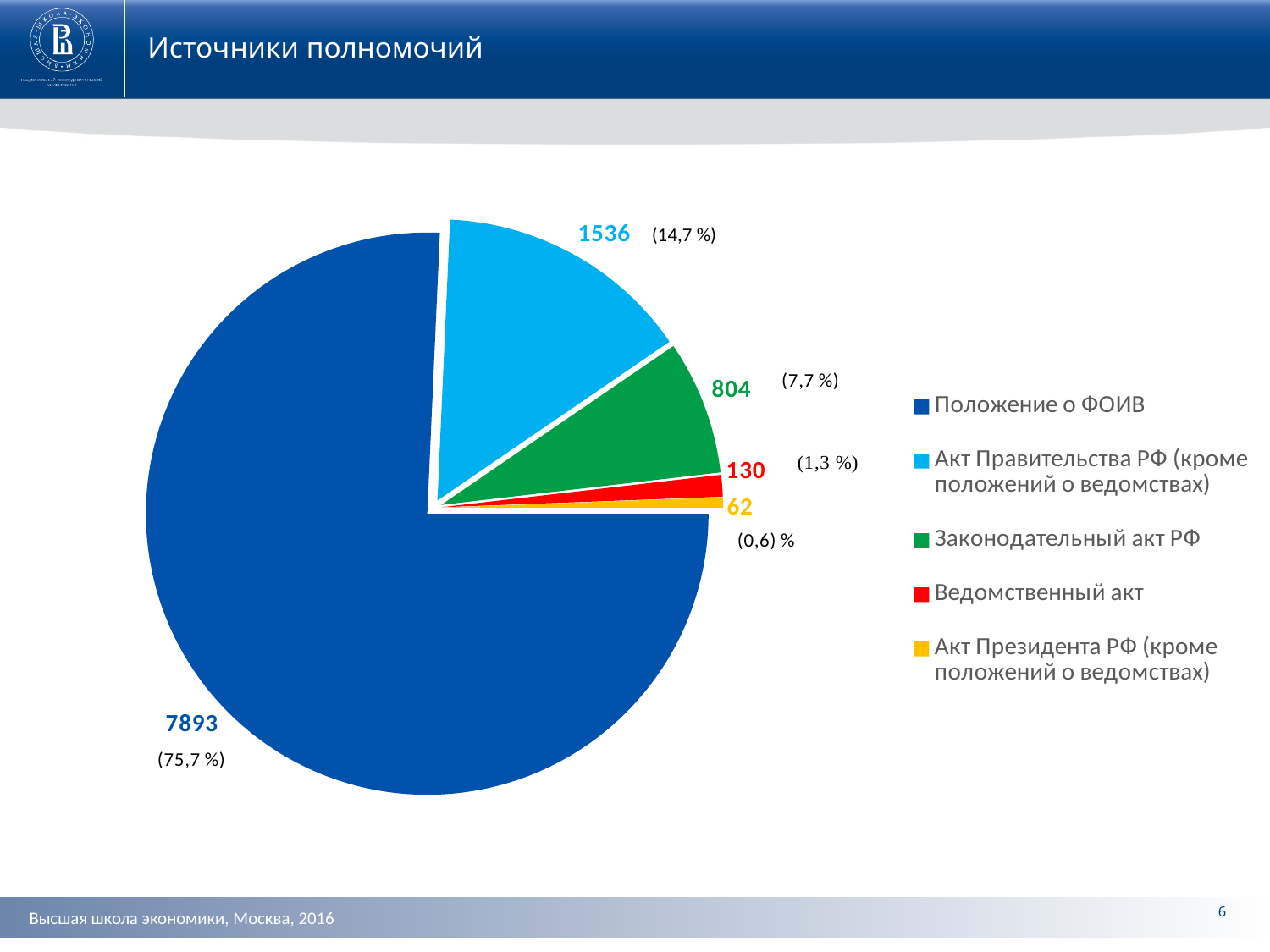
What is the difference between the values for Акт Правительства РФ (кроме положений о ведомствах) and Законодательный акт РФ? 732 How many categories does the pie chart have? 5 What is the value for Законодательный акт РФ? 804 What share of the pie does Законодательный акт РФ represent? 7,7 % What is the value for Акт Правительства РФ (кроме положений о ведомствах)? 1536 What is the value for Акт Президента РФ (кроме положений о ведомствах)? 62 What is the value for Ведомственный акт? 130 Which is larger, the value for Ведомственный акт or the value for Акт Президента РФ (кроме положений о ведомствах)? Ведомственный акт What kind of chart is shown on the slide? pie chart What is the value for Положение о ФОИВ? 7893 Which category has the smallest slice? Акт Президента РФ (кроме положений о ведомствах) Which category has the largest slice? Положение о ФОИВ